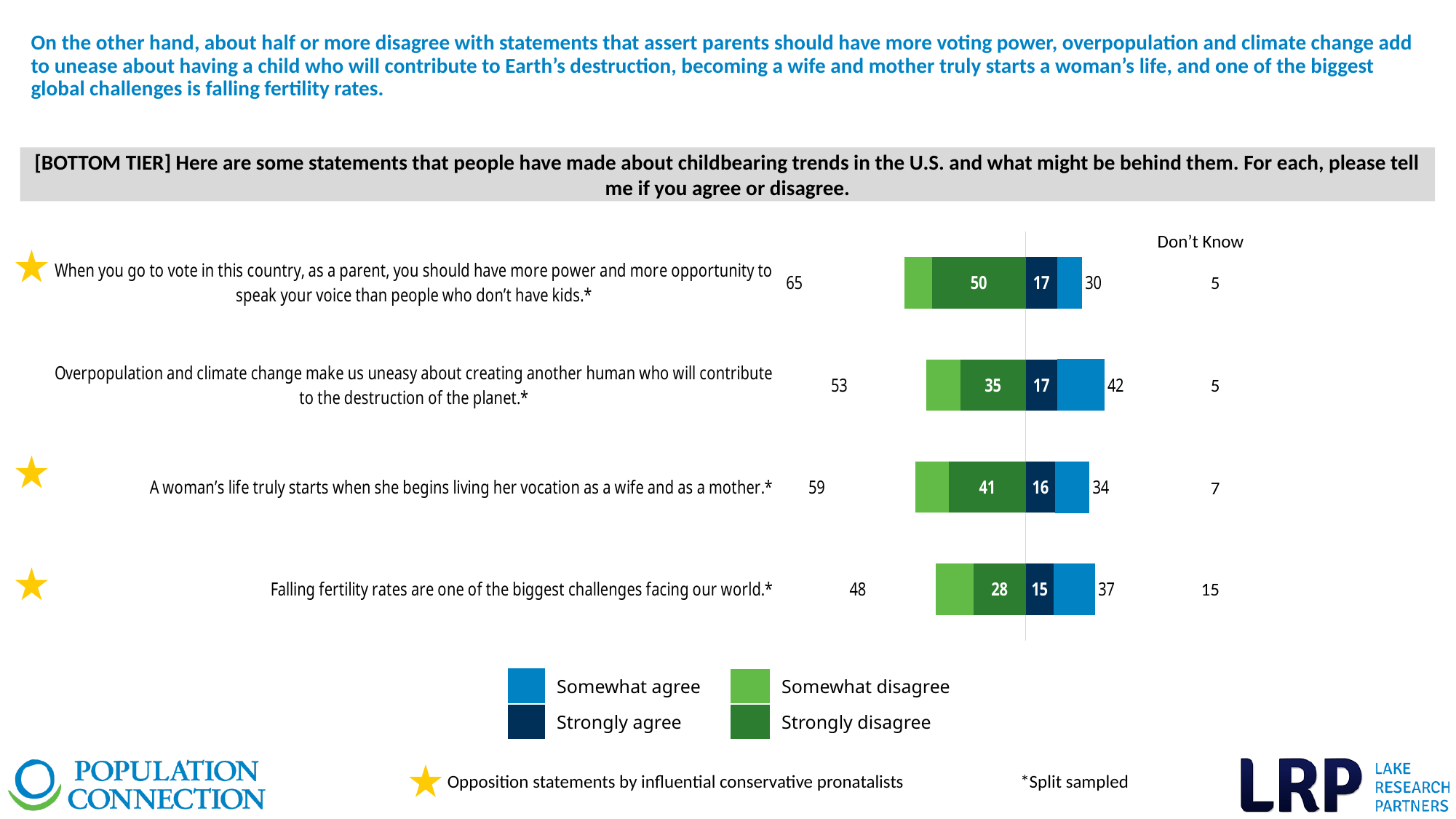
Which colour represents 'Strongly agree' in the legend? Dark navy blue Which statement has the lowest strongly disagree value? Falling fertility rates are one of the biggest challenges facing our world. What is the Don't Know value for the statement that falling fertility rates are one of the biggest challenges facing our world? 15 What kind of chart is shown on the slide? Stacked bar chart How many statements are shown in the chart? 4 What percentage strongly disagree that parents should have more voting power than people who don't have kids? 50 How many series does the legend list? 4 What is the total agree value for the statement that a woman's life truly starts when she begins living her vocation as a wife and as a mother? 34 Which statement has the highest total disagree value? When you go to vote in this country, as a parent, you should have more power and more opportunity to speak your voice than people who don't have kids. What is the total disagree value for the statement that overpopulation and climate change make us uneasy about creating another human? 53 Which statement has a larger total agree value: the one about overpopulation and climate change, or the one about falling fertility rates? Overpopulation and climate change make us uneasy about creating another human who will contribute to the destruction of the planet. What is the difference between the total disagree and total agree values for the statement about parents having more voting power? 35